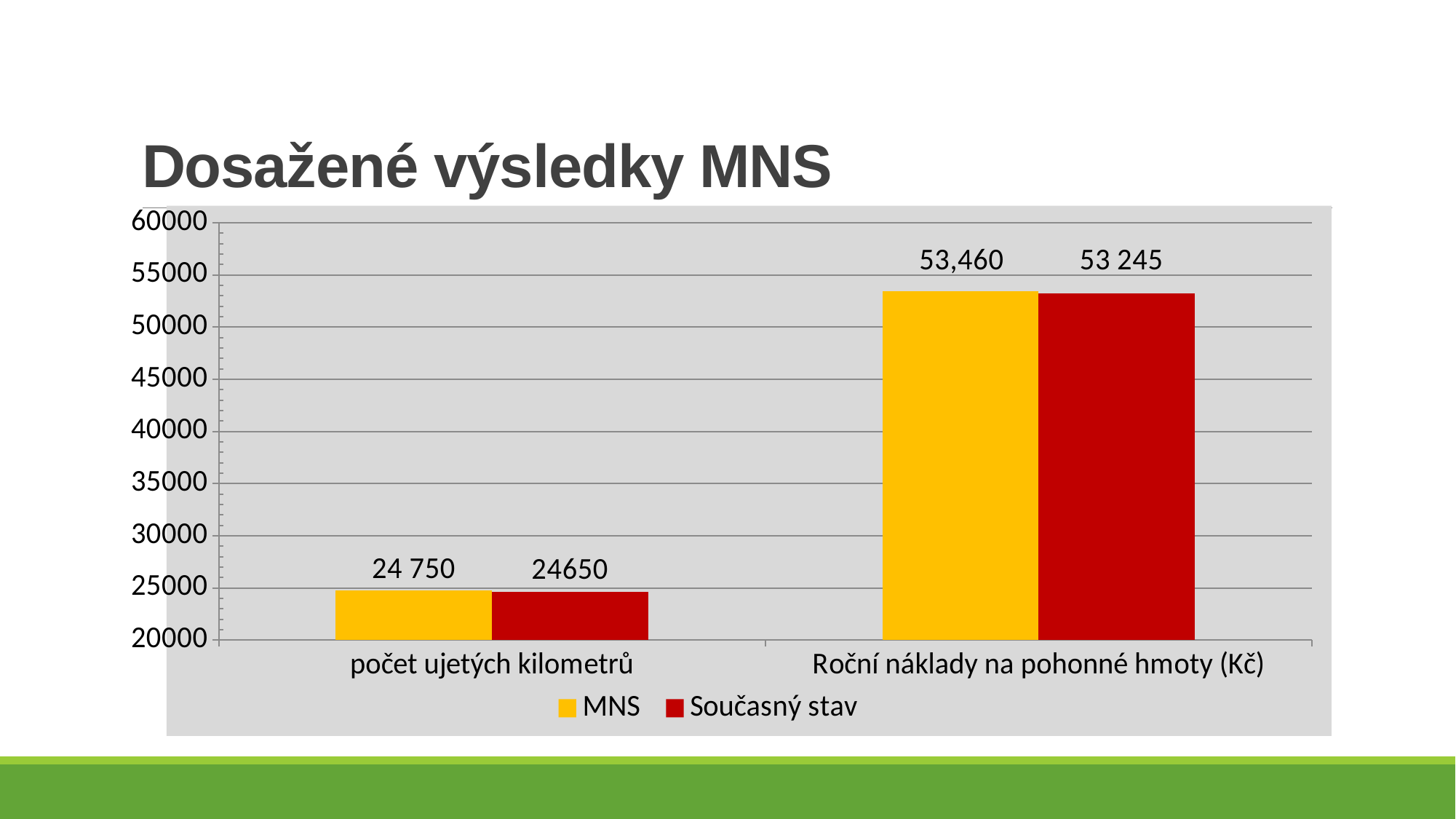
How many categories are shown on the x axis? 2 What is the difference between the MNS and Současný stav values for počet ujetých kilometrů? 100 Which category has the highest MNS value? Roční náklady na pohonné hmoty (Kč) What is the Současný stav value for počet ujetých kilometrů? 24650 What is the difference between the MNS and Současný stav values for Roční náklady na pohonné hmoty (Kč)? 215 What kind of chart is shown on the slide? bar chart How many series does the legend list? 2 Is the MNS value for Roční náklady na pohonné hmoty (Kč) greater or less than 50000? greater What is the MNS value for počet ujetých kilometrů? 24 750 What is the MNS value for Roční náklady na pohonné hmoty (Kč)? 53,460 Which category has the lowest Současný stav value? počet ujetých kilometrů What is the Současný stav value for Roční náklady na pohonné hmoty (Kč)? 53 245